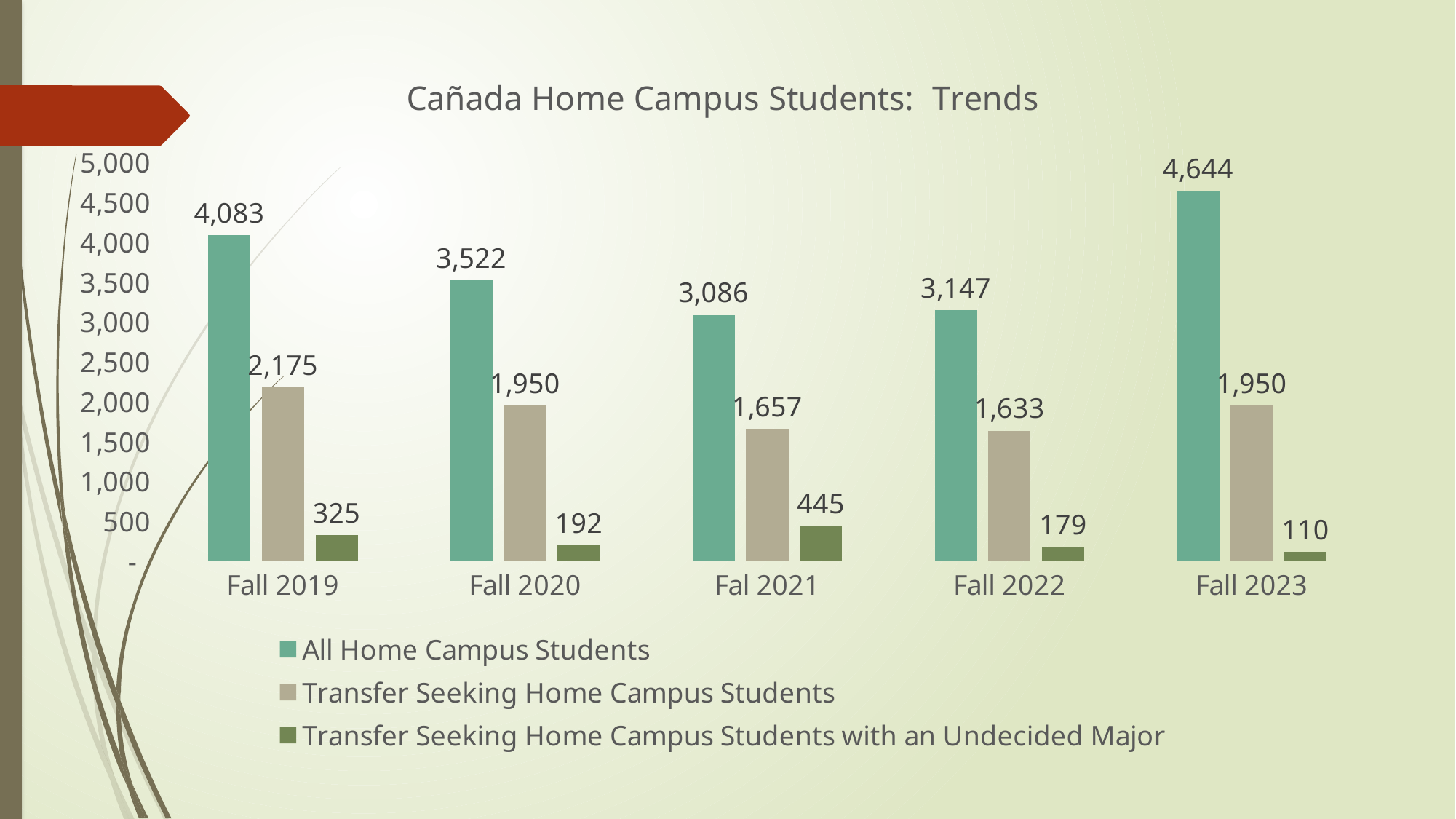
What is the value for Transfer Seeking Home Campus Students with an Undecided Major in Fal 2021? 445 What is the title of the chart? Cañada Home Campus Students: Trends What is the difference between All Home Campus Students in Fall 2023 and Fall 2019? 561 Does the value for Transfer Seeking Home Campus Students with an Undecided Major rise or fall from Fall 2022 to Fall 2023? Fall What is the value for Transfer Seeking Home Campus Students in Fall 2019? 2,175 What kind of chart is shown on the slide? Bar chart What is the value for All Home Campus Students in Fall 2023? 4,644 In which term is the value for Transfer Seeking Home Campus Students with an Undecided Major highest? Fal 2021 Which is larger: Transfer Seeking Home Campus Students in Fall 2020 or in Fall 2022? Fall 2020 How many series does the legend list? 3 In which term is the value for All Home Campus Students lowest? Fal 2021 How many terms are shown on the x axis? 5